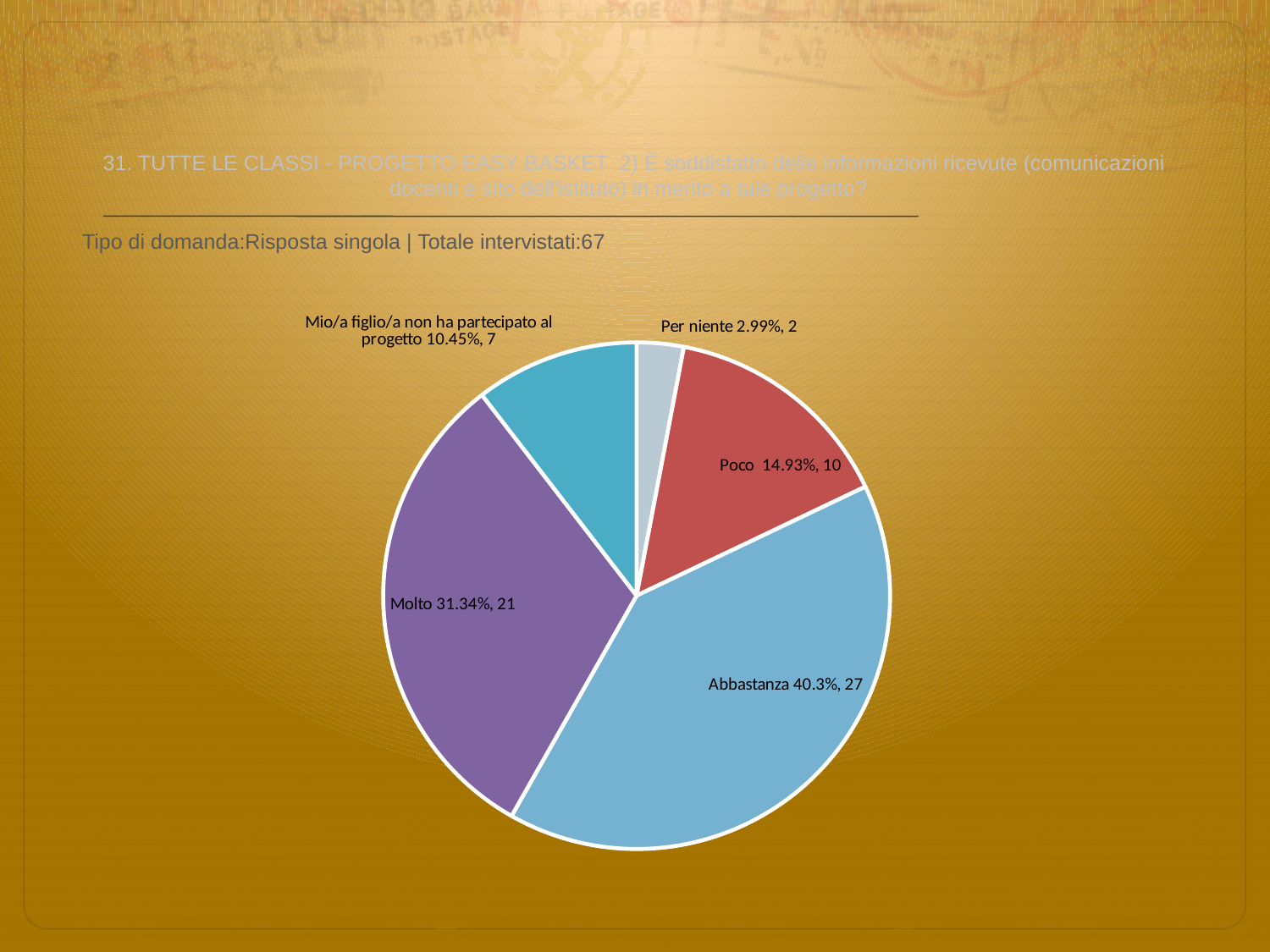
Which category has the largest slice of the pie? Abbastanza Which has more respondents, Poco or Mio/a figlio/a non ha partecipato al progetto? Poco How many slices does the pie chart have? 5 What percentage share does the Poco slice have? 14.93% What is the difference in respondent count between Abbastanza and Molto? 6 What is the total number of respondents (Totale intervistati) stated on the slide? 67 What kind of chart is shown on the slide? pie chart Which category has the smallest slice of the pie? Per niente What percentage share does the Abbastanza slice have? 40.3% How many respondents answered Molto? 21 What is the percentage share of the slice labelled Mio/a figlio/a non ha partecipato al progetto? 10.45% How many respondents answered Per niente? 2